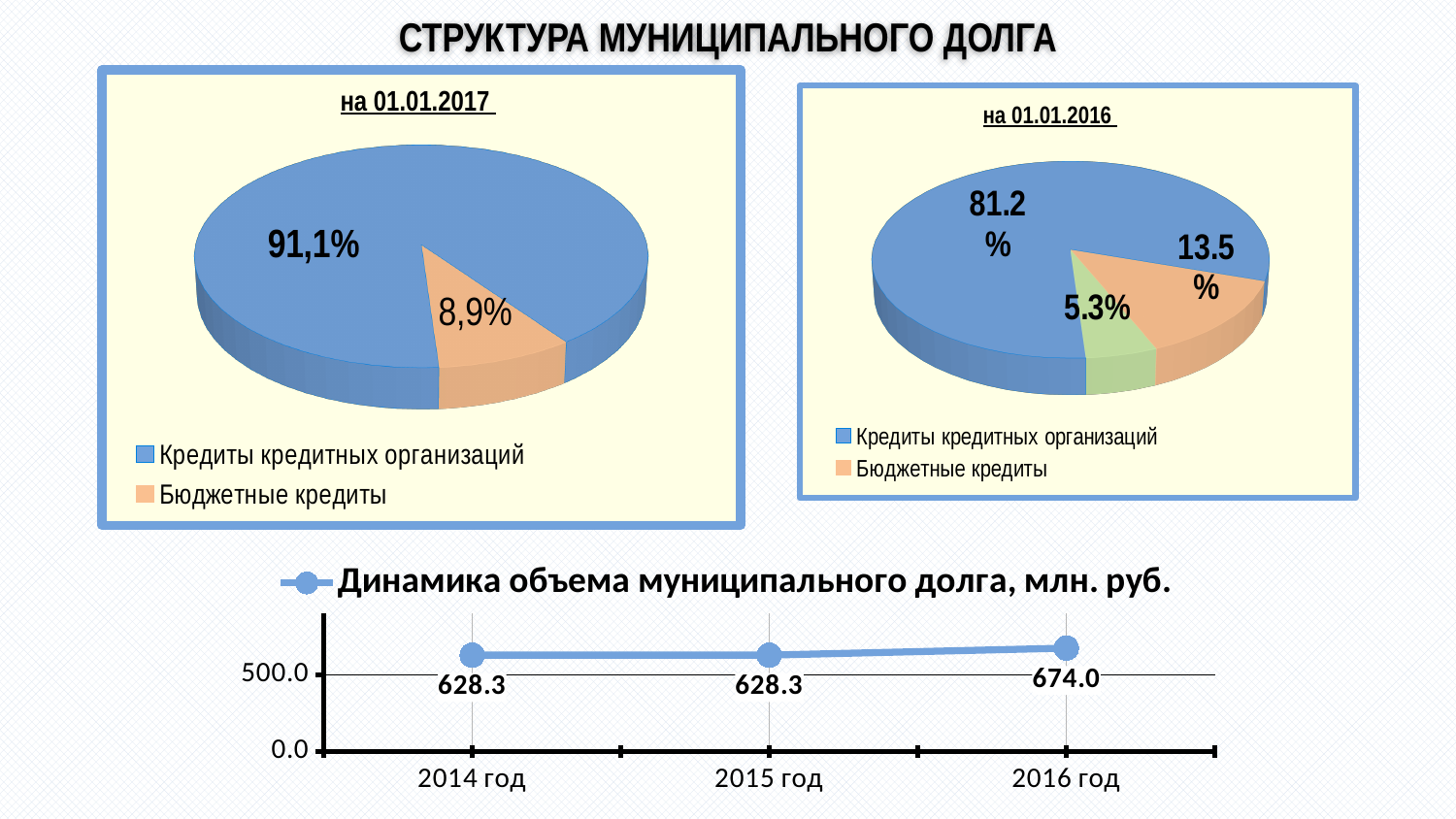
In the pie chart 'на 01.01.2017', what share is shown for Бюджетные кредиты? 8,9% In the pie chart 'на 01.01.2017', how many entries does the legend list? 2 In the pie chart 'на 01.01.2017', what share is shown for Кредиты кредитных организаций? 91,1% In the pie chart 'на 01.01.2016', how many slices does the pie have? 3 In the chart 'Динамика объема муниципального долга, млн. руб.', what is the value for 2014 год? 628.3 In the chart 'Динамика объема муниципального долга, млн. руб.', what is the difference between the values for 2016 год and 2015 год? 45.7 In the pie chart 'на 01.01.2016', what share is shown for Бюджетные кредиты? 13.5% In the pie chart 'на 01.01.2016', which slice is the largest? Кредиты кредитных организаций What kind of chart is 'Динамика объема муниципального долга, млн. руб.'? line chart In the pie chart 'на 01.01.2016', what share is shown for Кредиты кредитных организаций? 81.2% In the chart 'Динамика объема муниципального долга, млн. руб.', how many data points are plotted? 3 In the chart 'Динамика объема муниципального долга, млн. руб.', what is the value for 2016 год? 674.0